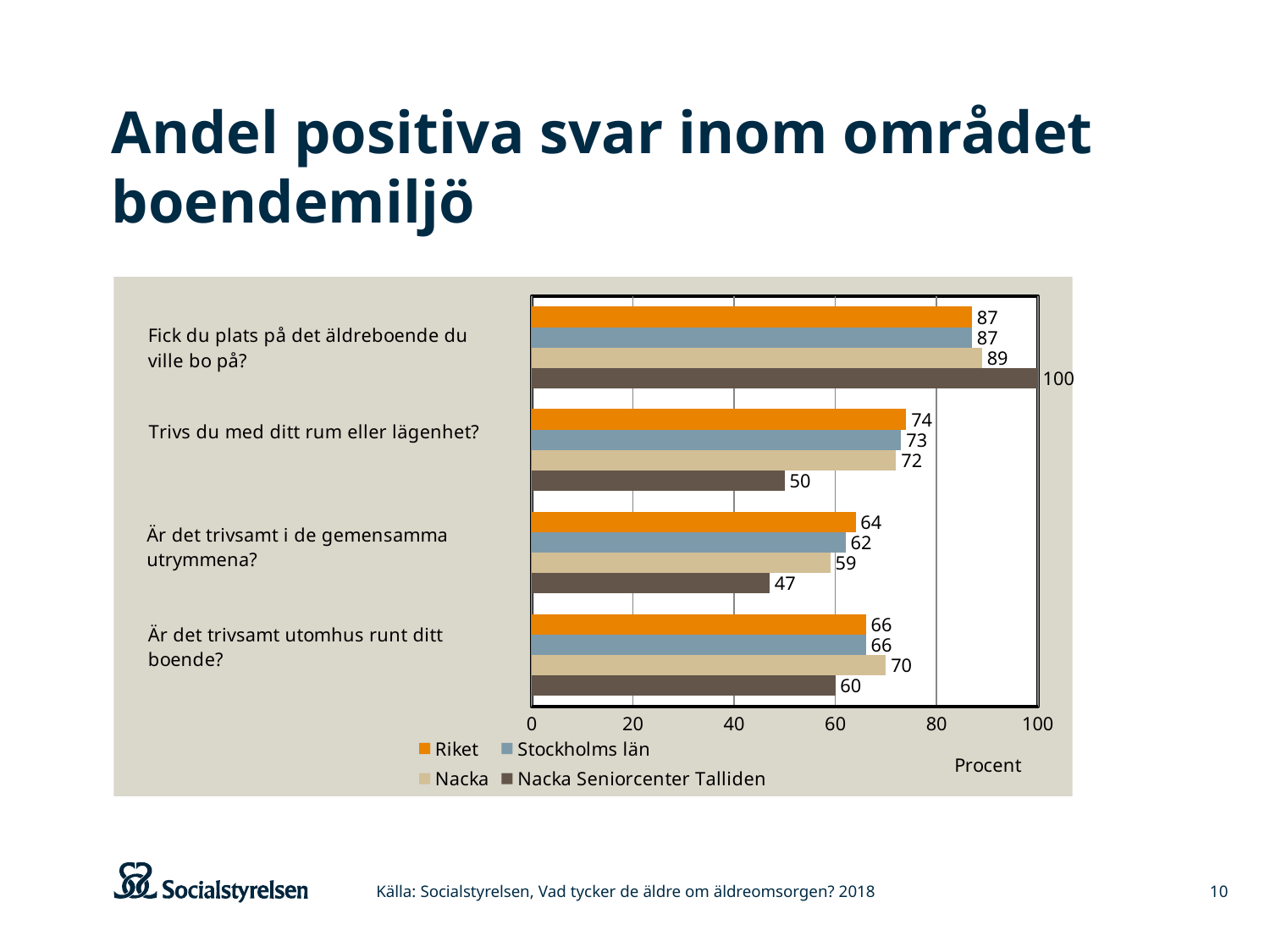
What value is shown for Riket for "Trivs du med ditt rum eller lägenhet?"? 74 Which question has the highest value for Riket? Fick du plats på det äldreboende du ville bo på? How many questions (categories) are shown on the chart? 4 What is the difference between Riket and Nacka Seniorcenter Talliden for "Trivs du med ditt rum eller lägenhet?"? 24 How many series does the legend list? 4 What is the label of the horizontal axis? Procent What kind of chart is shown on the slide? Bar chart Which is larger for "Är det trivsamt utomhus runt ditt boende?": Nacka or Nacka Seniorcenter Talliden? Nacka Which question has the lowest value for Nacka Seniorcenter Talliden? Är det trivsamt i de gemensamma utrymmena? What value is shown for Nacka Seniorcenter Talliden for "Fick du plats på det äldreboende du ville bo på?"? 100 What value is shown for Nacka for "Är det trivsamt utomhus runt ditt boende?"? 70 What value is shown for Stockholms län for "Är det trivsamt i de gemensamma utrymmena?"? 62